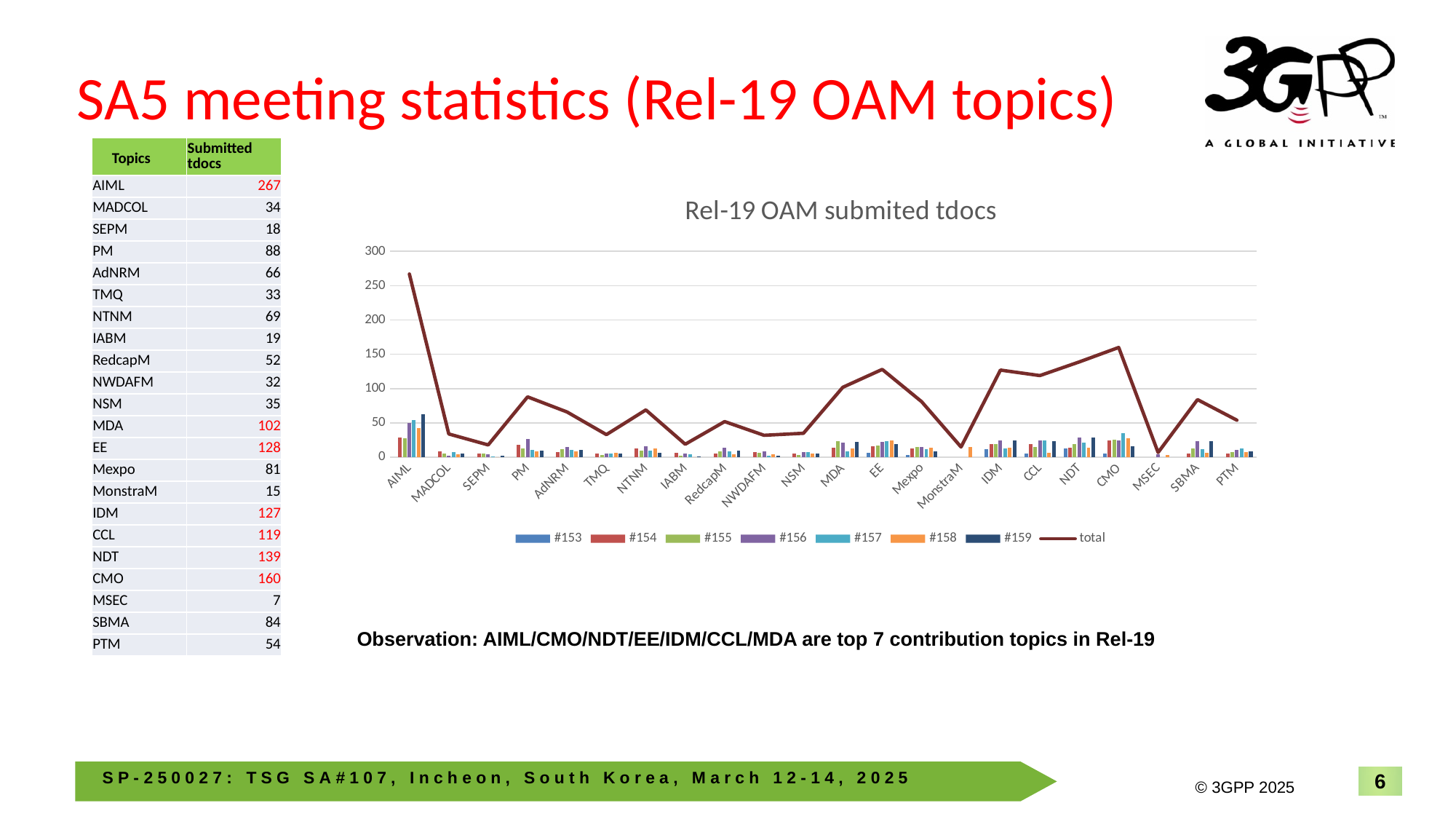
How many series does the chart legend list? 8 What is the difference between the total submitted tdocs for AIML and CMO? 107 Does the total line rise or fall from CMO to MSEC? fall What is the title of the chart? Rel-19 OAM submited tdocs Is the total value for SBMA greater or less than 50? greater Which has a larger total of submitted tdocs, EE or MDA? EE What kind of chart is shown on the slide? Combined bar and line chart How many topics are plotted along the x axis of the chart? 22 Which topic has the lowest total of submitted tdocs? MSEC What is the total number of submitted tdocs for CMO? 160 What is the total number of submitted tdocs for NDT? 139 Which topic has the highest total of submitted tdocs? AIML